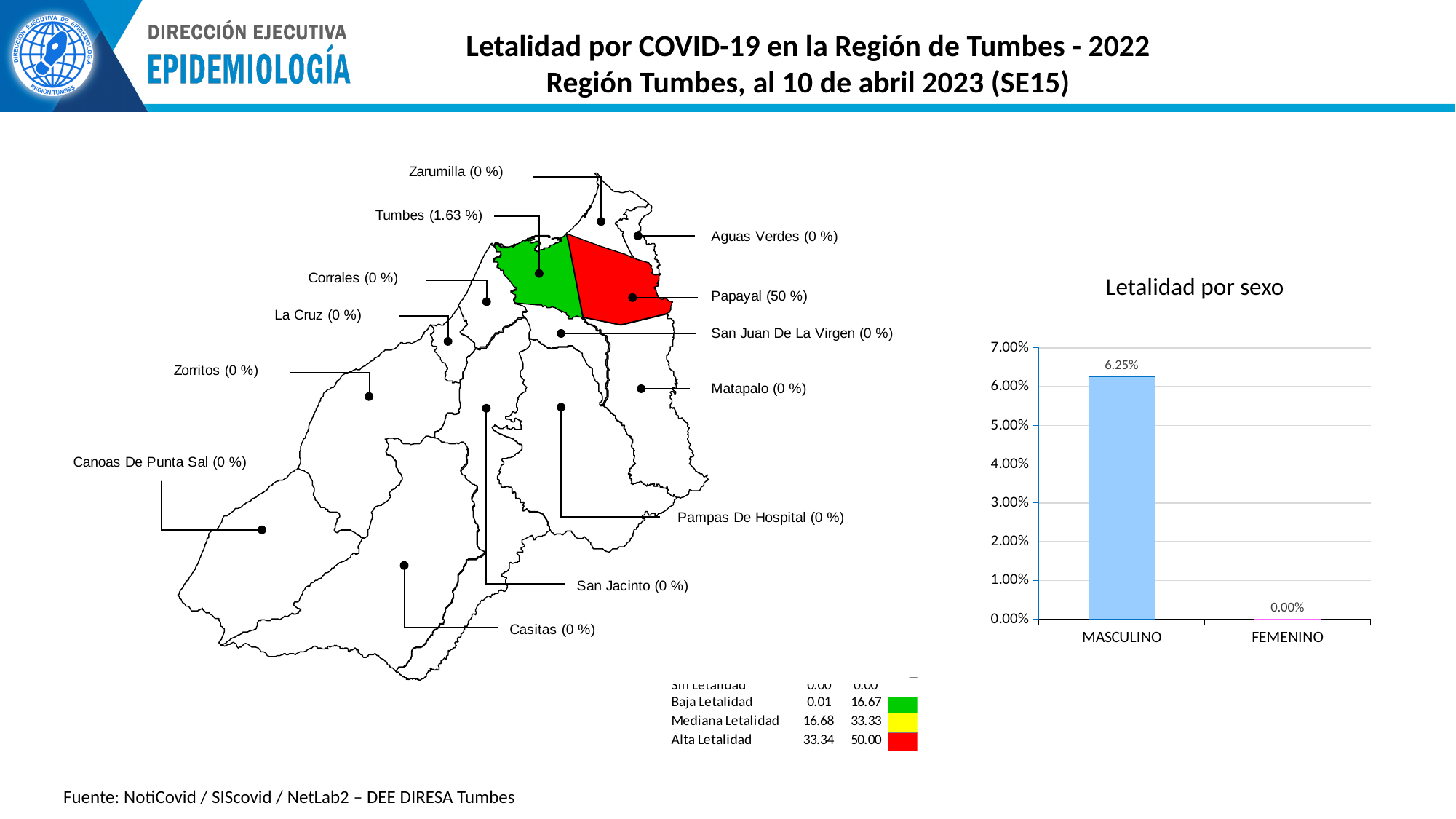
In the 'Letalidad por sexo' chart, what is the value for FEMENINO? 0.00% In the 'Letalidad por sexo' chart, what is the difference between the MASCULINO and FEMENINO values? 6.25% On the map, what is the lethality value shown for Papayal? 50 % What kind of chart is 'Letalidad por sexo'? bar chart In the 'Letalidad por sexo' chart, which category has the lowest value? FEMENINO In the 'Letalidad por sexo' chart, what is the value for MASCULINO? 6.25% How many categories are shown on the x axis of the 'Letalidad por sexo' chart? 2 In the 'Letalidad por sexo' chart, which category has the highest value? MASCULINO What is the highest value shown on the y axis of the 'Letalidad por sexo' chart? 7.00% In the 'Letalidad por sexo' chart, is the value for MASCULINO greater or less than 6.00%? greater On the map, which district has the highest lethality value? Papayal On the map, what is the lethality value shown for Tumbes? 1.63 %